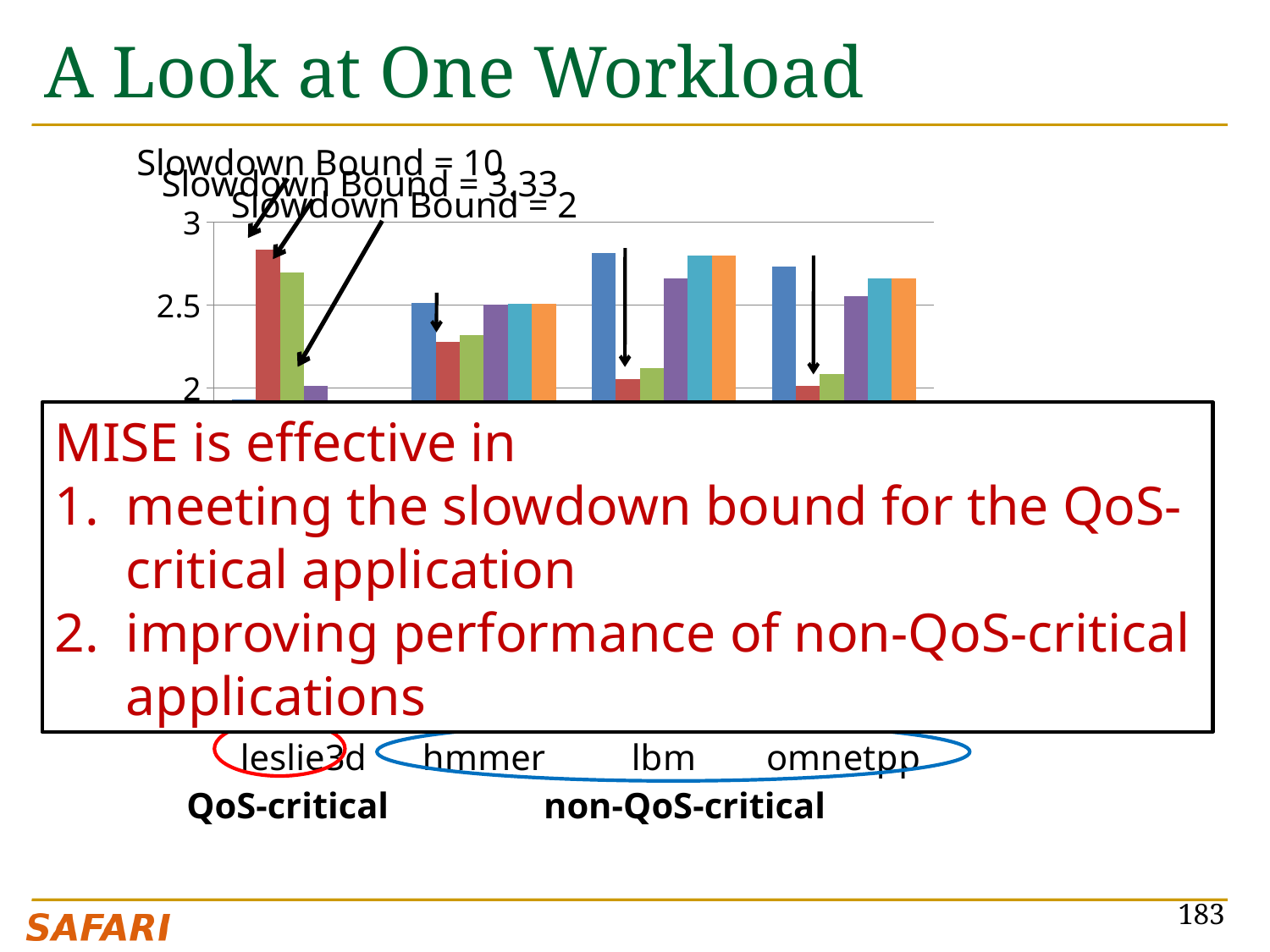
How many applications are grouped under the non-QoS-critical label? 3 Does any bar in the chart reach the 3 tick on the y axis? No How many 'Slowdown Bound' annotations point at the chart? 3 Is the shortest visible bar for lbm greater or less than 2.5? less Is the shortest visible bar for omnetpp greater or less than 2.5? less Which application on the x axis is labelled as QoS-critical? leslie3d How many application categories are labelled on the x axis of the chart? 4 What kind of chart is shown on the slide? bar chart